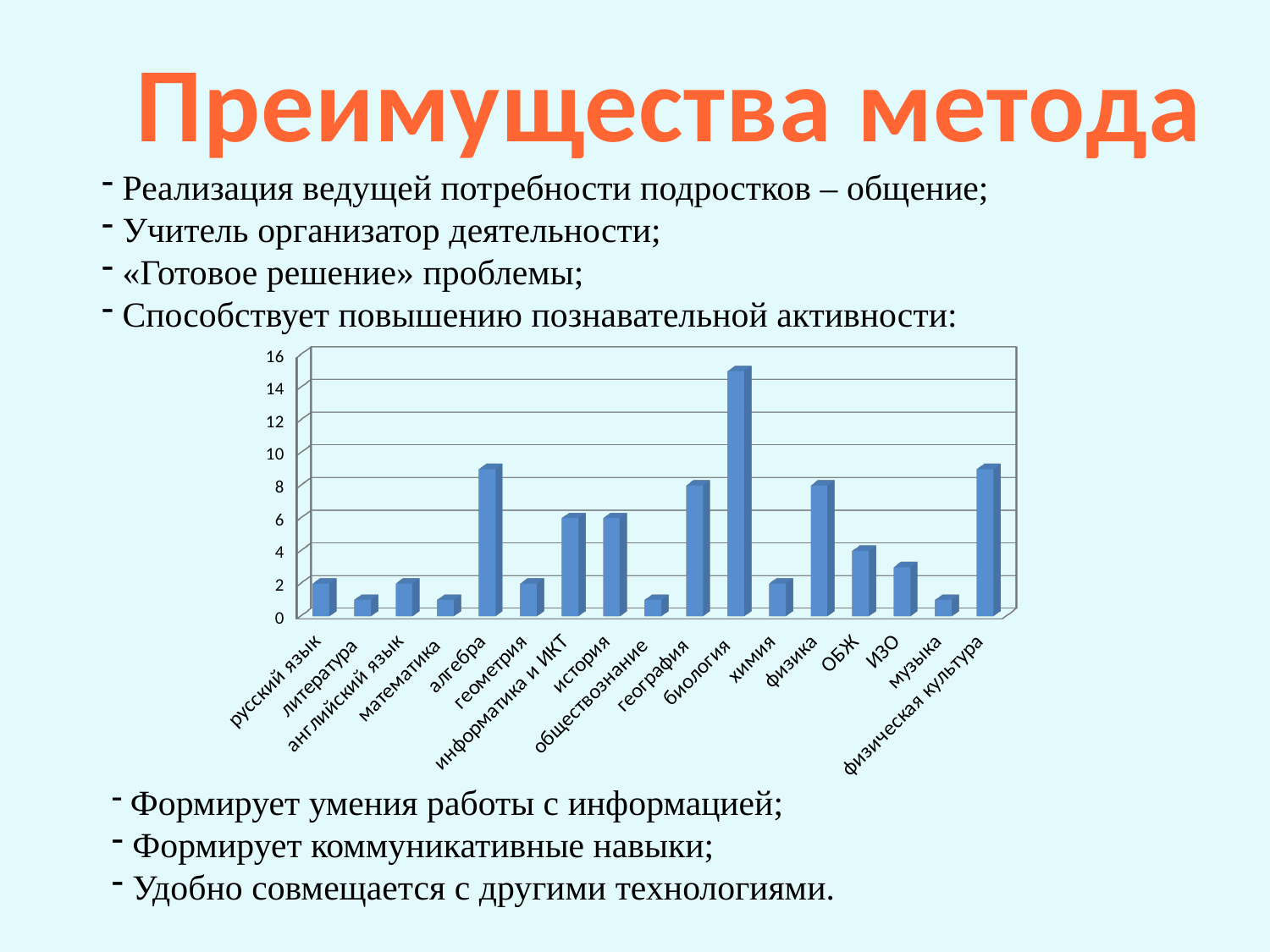
Is the value for алгебра greater or less than 8? greater Which is larger, the value for история or the value for обществознание? история Which subject has the highest bar in the chart? биология Which is larger, the value for биология or the value for физика? биология Is the value for ИЗО greater or less than 4? less Is the value for биология greater or less than 14? greater How many subject categories are shown on the x axis of the chart? 17 What kind of chart is shown on the slide? bar chart Which is larger, the value for ОБЖ or the value for музыка? ОБЖ What is the highest value shown on the vertical axis of the chart? 16